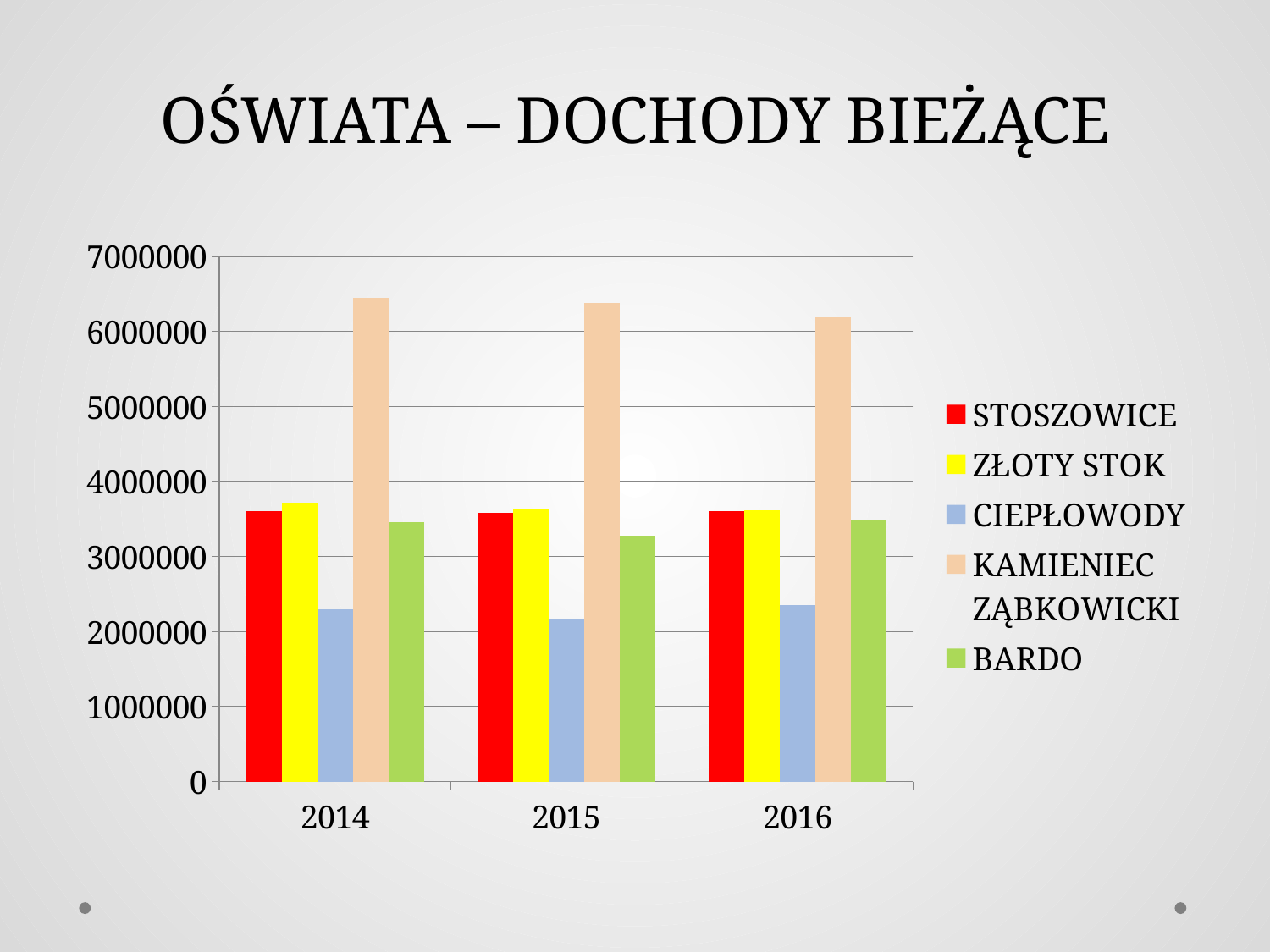
What kind of chart is shown on the slide? bar chart In 2016, which is larger: the value for KAMIENIEC ZĄBKOWICKI or the value for CIEPŁOWODY? KAMIENIEC ZĄBKOWICKI What is the title of the slide? OŚWIATA – DOCHODY BIEŻĄCE How many series does the legend list? 5 Is the value for CIEPŁOWODY in 2015 greater or less than 3000000? less How many years are shown on the x axis? 3 Is the value for BARDO in 2016 greater or less than 3000000? greater What colour represents BARDO in the chart? green Which series has the highest value in 2014? KAMIENIEC ZĄBKOWICKI Which series has the lowest value in 2015? CIEPŁOWODY Do the values for KAMIENIEC ZĄBKOWICKI rise or fall from 2014 to 2016? fall Is the value for KAMIENIEC ZĄBKOWICKI in 2014 greater or less than 6000000? greater